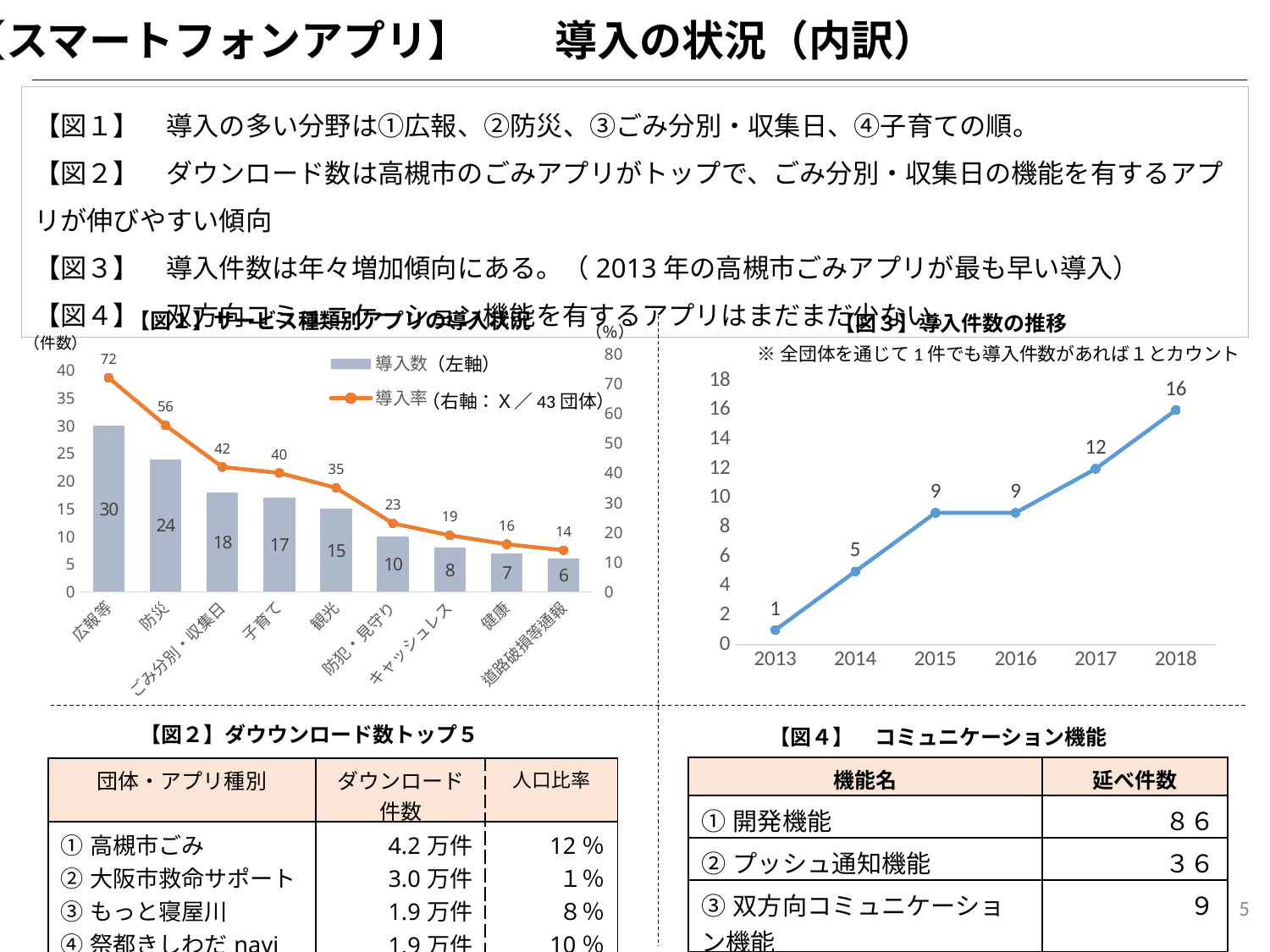
【図1】のグラフで、「観光」と「健康」では、どちらの導入数が多いですか？ 観光 【図1】のグラフで、「ごみ分別・収集日」の導入率は何%ですか？ 42 【図1】のグラフには、いくつの分野（カテゴリ）が表示されていますか？ 9 【図3】のグラフで、2018年と2014年の導入件数の差はいくつですか？ 11 【図3】のグラフで、2013年から2018年にかけて導入件数は増加していますか、減少していますか？ 増加 【図1】サービス種類別アプリの導入状況のグラフで、「広報等」の導入数はいくつですか？ 30 【図1】のグラフの凡例には、いくつの系列が示されていますか？ 2 【図1】のグラフで、導入数が最も少ない分野はどれですか？ 道路破損等通報 【図1】のグラフで、右軸に対応する系列の凡例名は何ですか？ 導入率（右軸：X／43団体） 【図3】導入件数の推移のグラフは、どの種類のグラフですか？ 折れ線グラフ 【図3】のグラフで、2017年の導入件数はいくつですか？ 12 【図1】のグラフで、「防災」と「子育て」の導入数の差はいくつですか？ 7